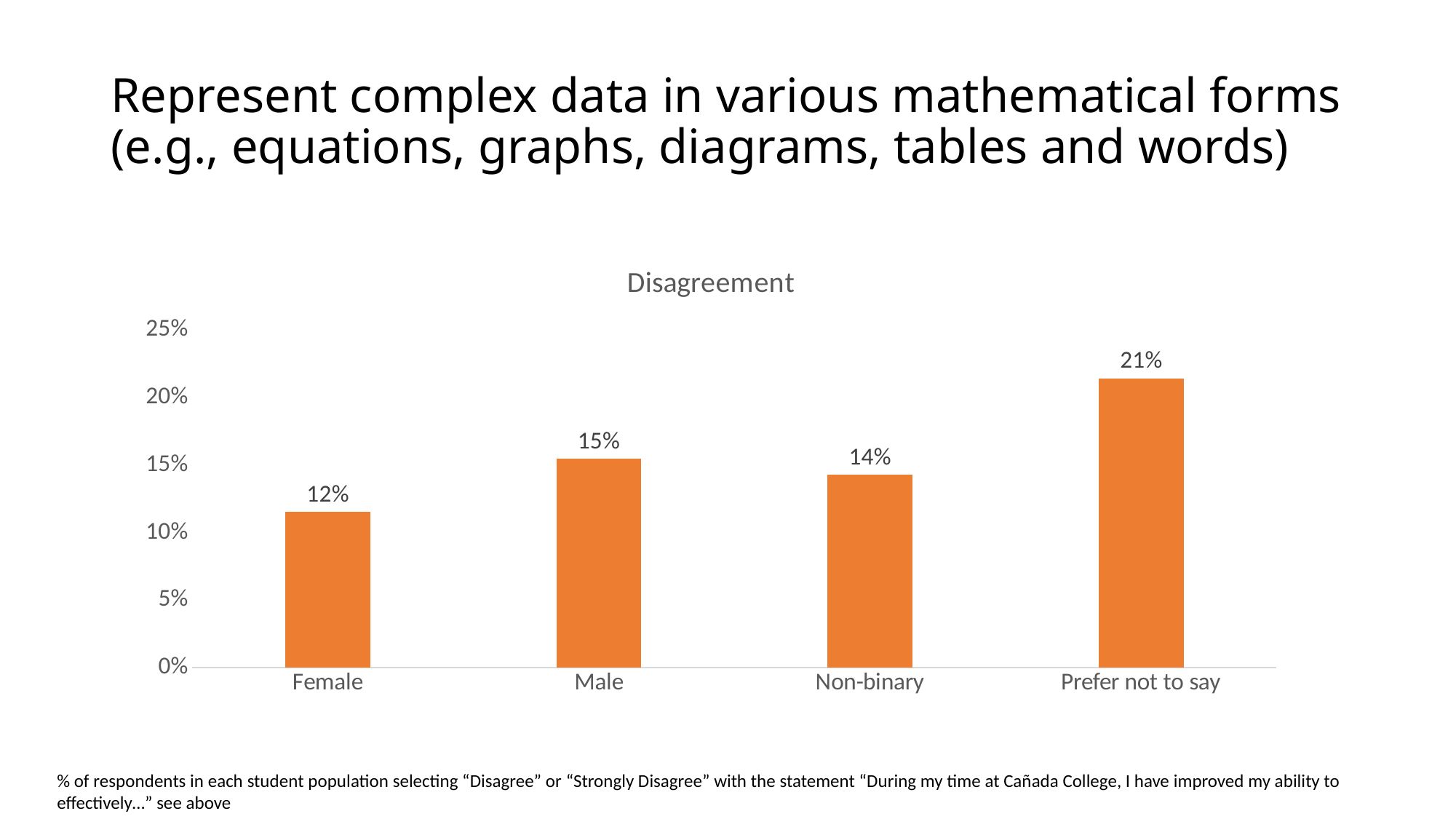
What is the value for Prefer not to say? 21% Which category has the lowest value? Female Is the value for Prefer not to say greater or less than 20%? greater What is the value for Female? 12% Which category has the highest value? Prefer not to say What is the value for Male? 15% What kind of chart is shown on the slide? Bar chart What is the difference between the values for Prefer not to say and Female? 9% What is the title of the chart? Disagreement How many categories are shown on the x axis? 4 What is the value for Non-binary? 14% Which is larger, the value for Male or the value for Female? Male